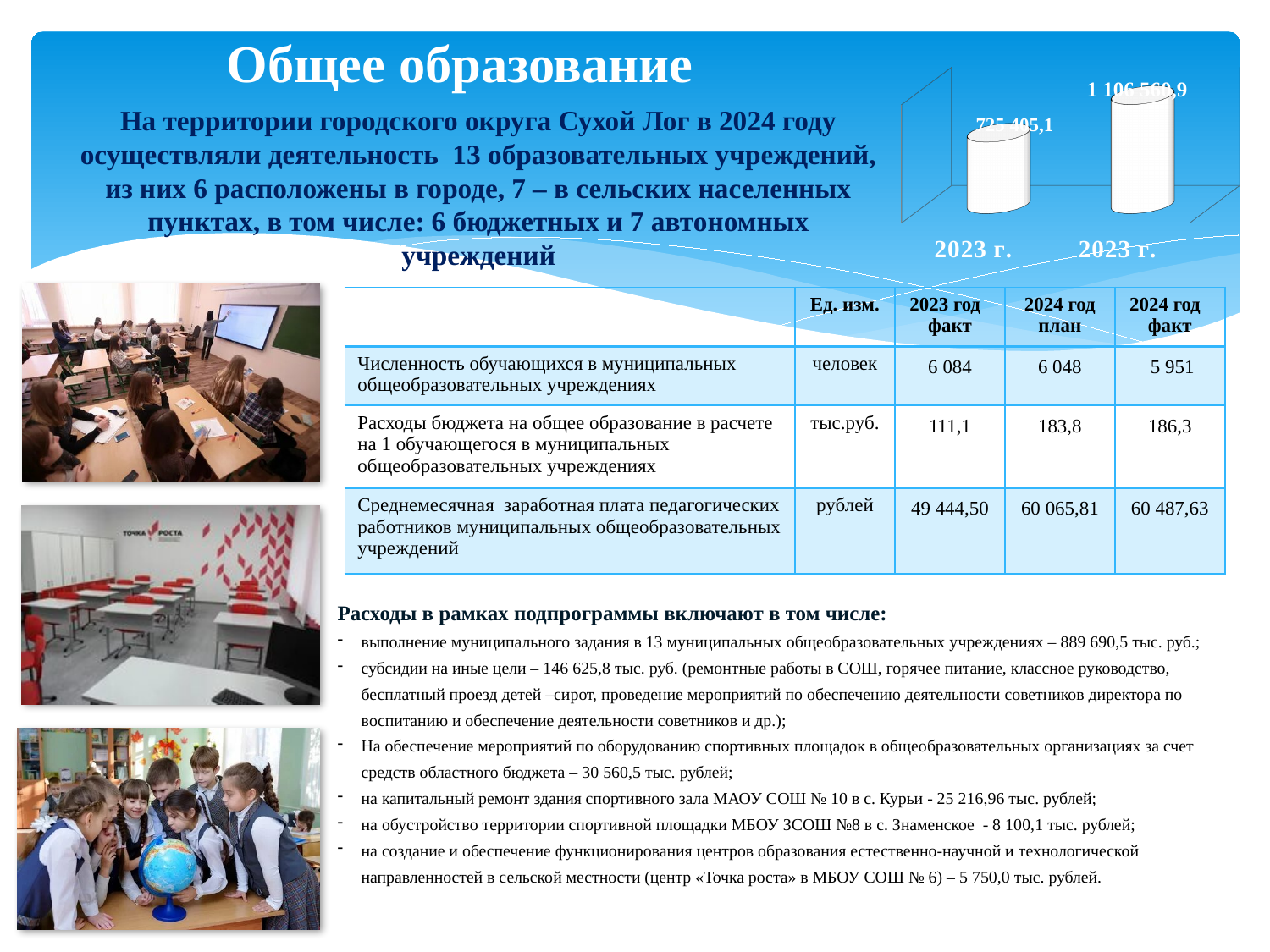
What kind of chart is shown in the top right corner of the slide? bar chart In the chart in the top right corner of the slide, which bar has the lowest value? the left (first) bar In the chart in the top right corner of the slide, which bar is taller, the left one or the right one? the right one How many bars does the chart in the top right corner of the slide have? 2 Do the values in the chart in the top right corner of the slide rise or fall from left to right? rise In the chart in the top right corner of the slide, which bar has the highest value? the right (second) bar Are the bars in the chart in the top right corner of the slide vertical or horizontal? vertical What label is printed under the left bar of the chart in the top right corner of the slide? 2023 г.